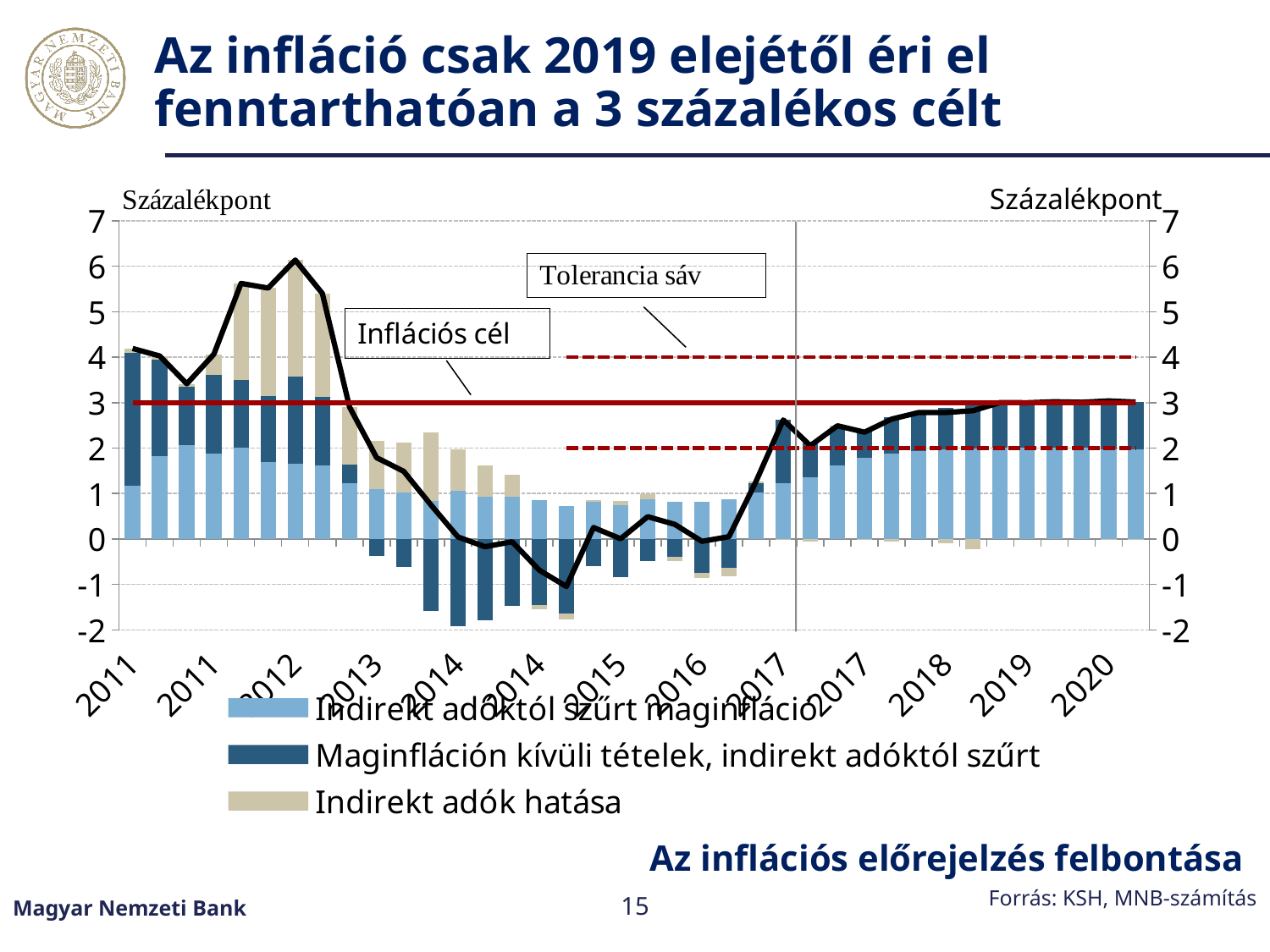
At what values are the two dashed lines of the 'Tolerancia sáv' drawn? 2 and 4 How many series does the legend list? 3 What is the title of the chart? Az inflációs előrejelzés felbontása Is the value of the black line at the end of the forecast in 2020 greater or less than 2? greater Does the black line rise or fall between its 2012 peak and 2014? fall At what value is the solid red line labelled 'Inflációs cél' drawn? 3 Which is larger: the black line's value at the start of 2011 or its value at the start of 2016? Start of 2011 Is the value of the black line at the start of 2011 greater or less than 3? greater Is the peak value of the black line in 2012 greater or less than 5? greater What kind of chart is shown on the slide? Stacked bar chart with a line In which year does the black line reach its highest value? 2012 What unit is shown on the vertical axis of the chart? Százalékpont